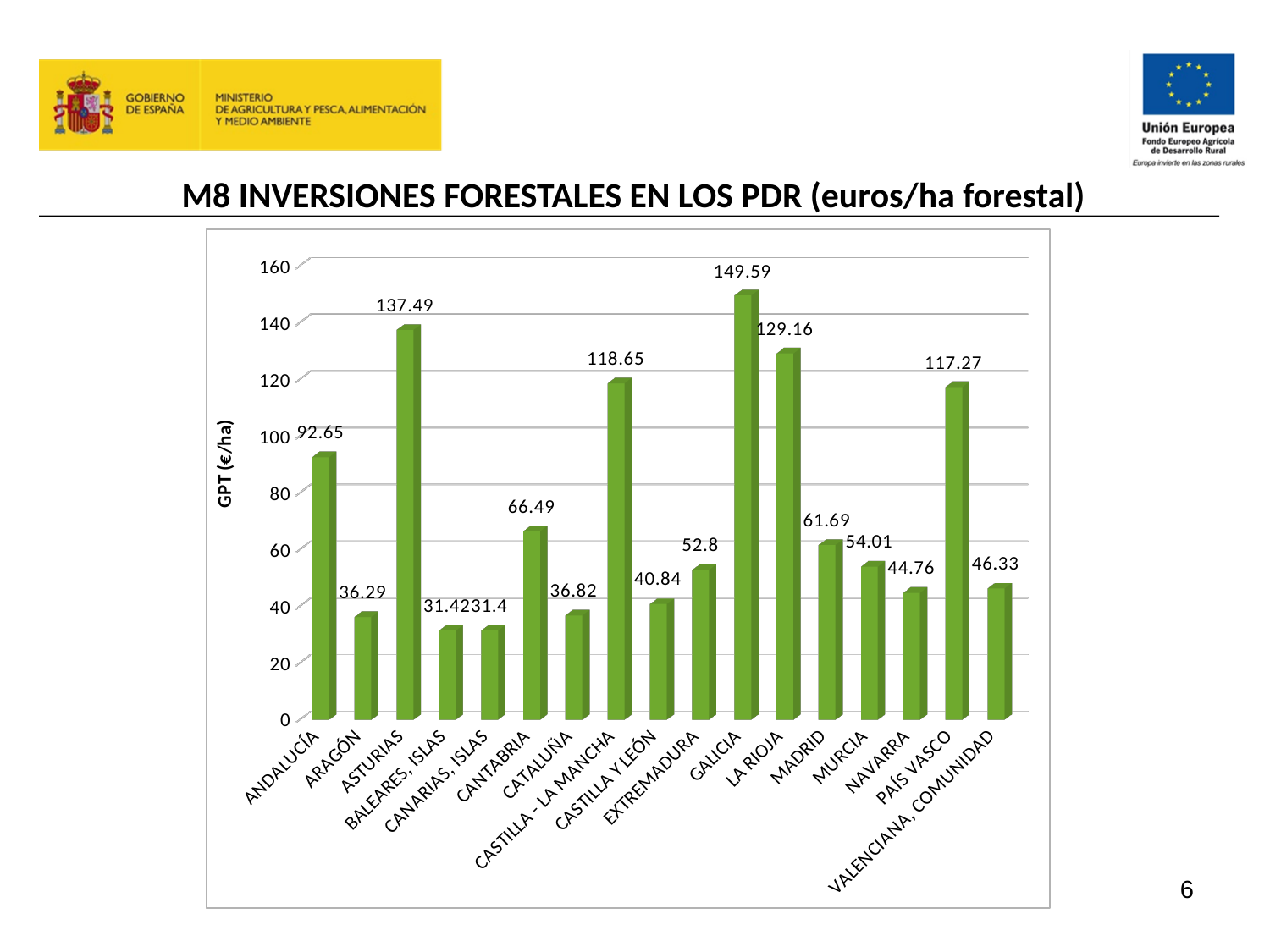
What is the value for GALICIA? 149.59 What kind of chart is shown on the slide? bar chart What is the label of the vertical axis? GPT (€/ha) What is the value for EXTREMADURA? 52.8 What is the difference between the values for GALICIA and ASTURIAS? 12.1 What is the value for NAVARRA? 44.76 What is the difference between the values for MADRID and MURCIA? 7.68 What is the value for CASTILLA - LA MANCHA? 118.65 Which region has the highest value? GALICIA Is the value for ANDALUCÍA greater or less than 80? greater How many regions are shown on the x axis? 17 Which has a larger value, CANTABRIA or MADRID? CANTABRIA